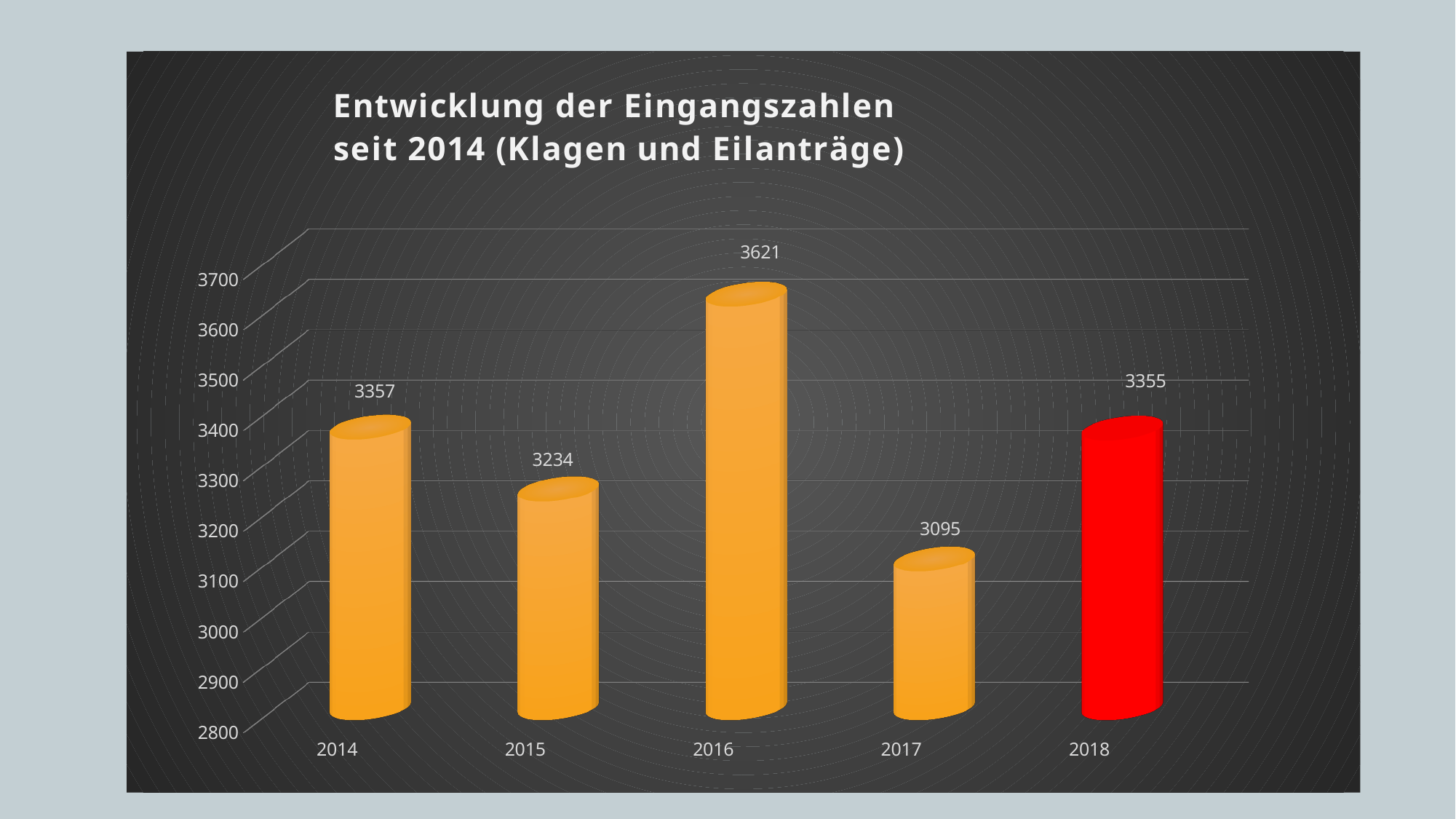
How many years are shown on the x axis? 5 What is the value for 2018? 3355 Which year has the highest value? 2016 Which year has the lowest value? 2017 What is the difference between the values for 2014 and 2015? 123 Is the value for 2016 greater or less than 3500? greater Which is larger, the value for 2015 or the value for 2018? 2018 What is the value for 2017? 3095 Which bar is coloured red? 2018 What is the value for 2014? 3357 What is the difference between the values for 2016 and 2017? 526 What kind of chart is shown on the slide? bar chart